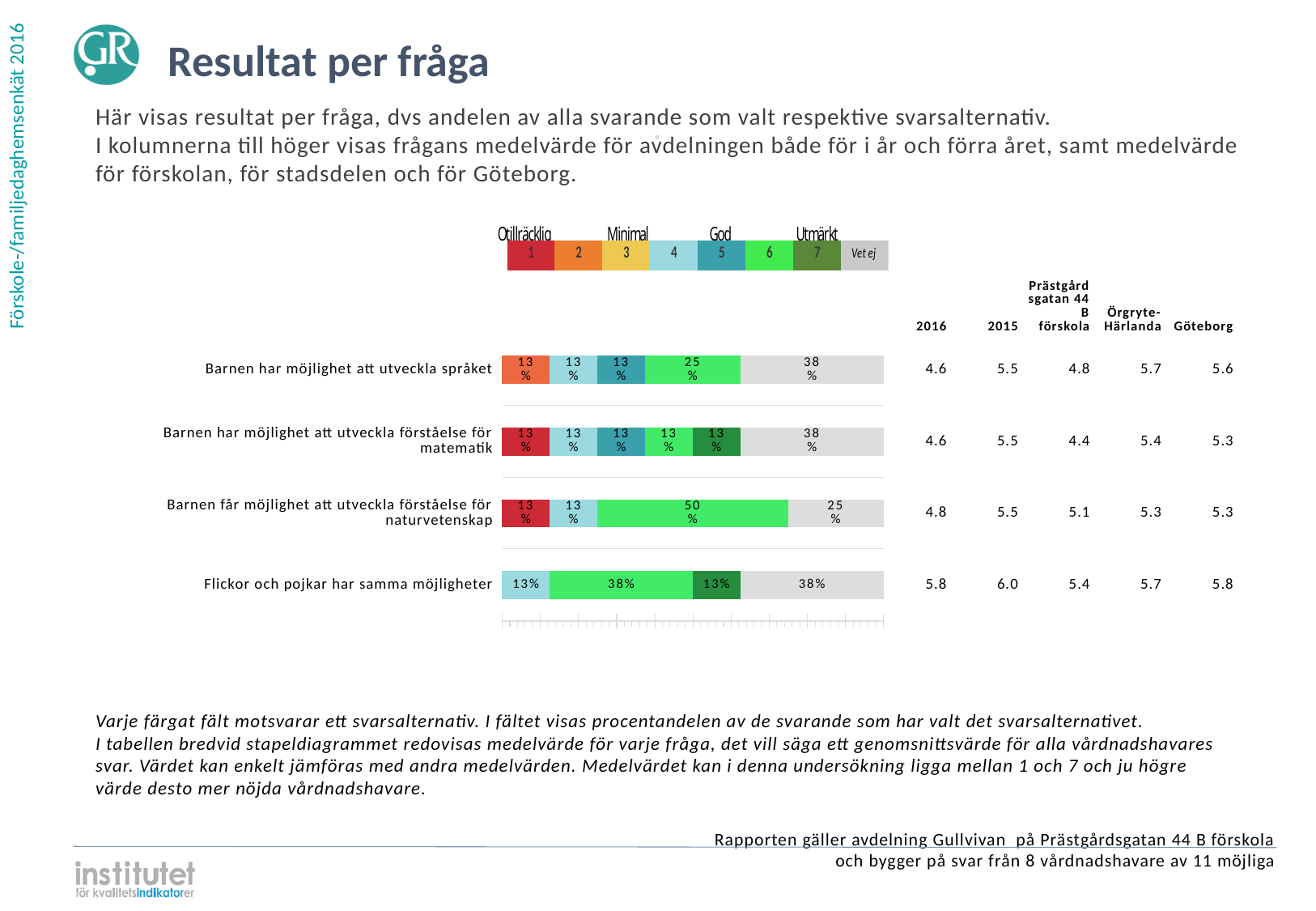
How many questions (categories) are shown as bars in the chart? 4 Which question has the largest single segment in its bar? Barnen får möjlighet att utveckla förståelse för naturvetenskap Which is larger: the option 6 share for 'Barnen har möjlighet att utveckla språket' or for 'Barnen får möjlighet att utveckla förståelse för naturvetenskap'? Barnen får möjlighet att utveckla förståelse för naturvetenskap What percentage chose option 6 (bright green) for 'Barnen får möjlighet att utveckla förståelse för naturvetenskap'? 50% What is the difference between the 'Vet ej' share for 'Barnen har möjlighet att utveckla förståelse för matematik' (38%) and for 'Barnen får möjlighet att utveckla förståelse för naturvetenskap' (25%)? 13 percentage points What kind of chart is used to show the results per question on this slide? Stacked bar chart Which question has the highest 2016 mean value in the table? Flickor och pojkar har samma möjligheter How many response options does the legend above the chart list, including 'Vet ej'? 8 What is the 2016 mean value for 'Flickor och pojkar har samma möjligheter' in the table next to the chart? 5.8 What percentage chose option 6 (bright green) for 'Flickor och pojkar har samma möjligheter'? 38% What percentage of respondents answered 'Vet ej' for 'Barnen har möjlighet att utveckla språket'? 38% What is the Göteborg mean value for 'Barnen har möjlighet att utveckla förståelse för matematik'? 5.3